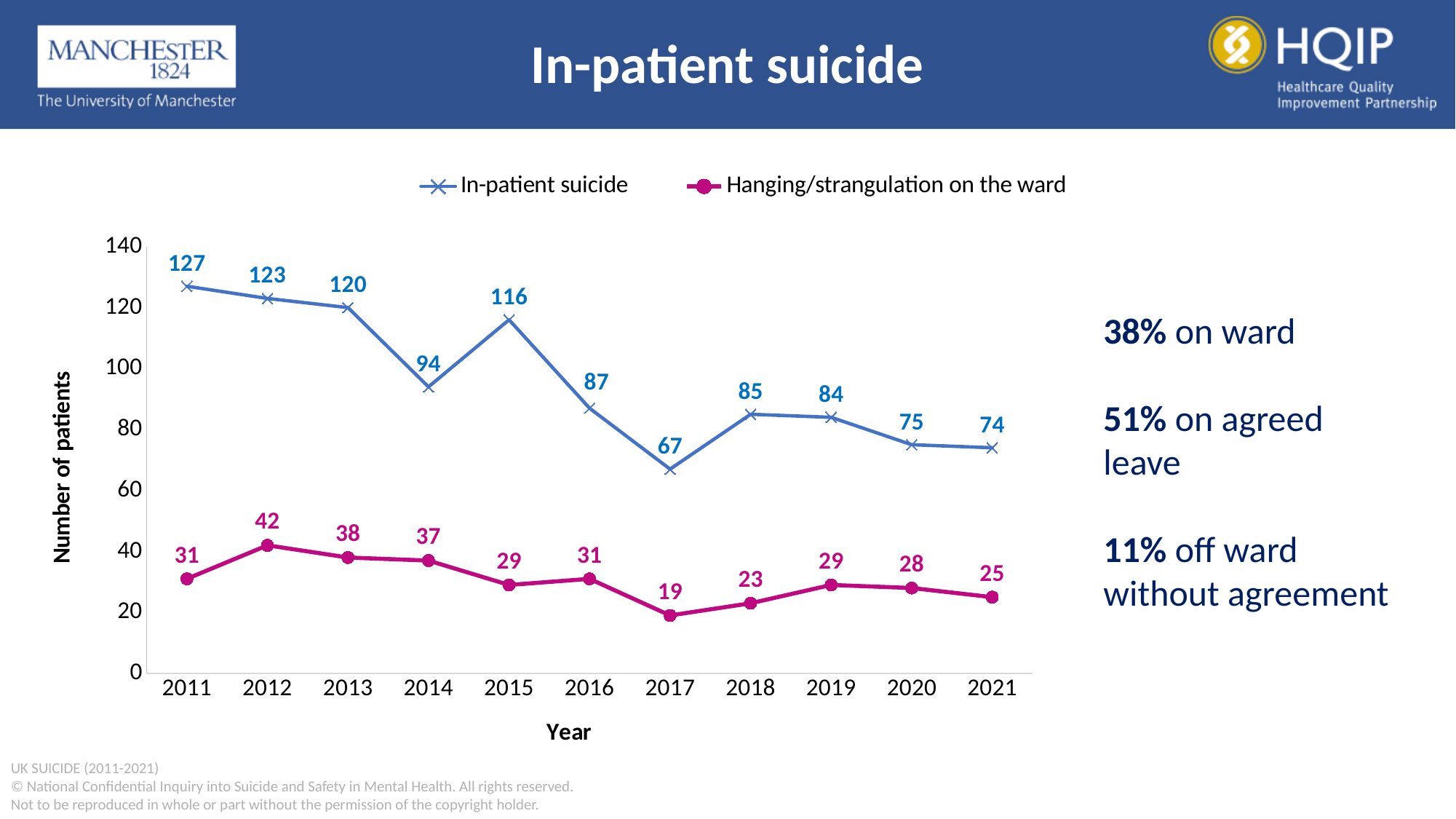
Overall, do in-patient suicides rise or fall from 2011 to 2021? Fall What was the number of hanging/strangulation on the ward cases in 2017? 19 What is the label on the y axis of the chart? Number of patients What is the difference between in-patient suicides in 2011 and 2021? 53 Which was larger, in-patient suicides in 2014 or in 2015? 2015 In which year was the number of in-patient suicides lowest? 2017 What kind of chart is shown on the slide? Line chart In which year was the number of hanging/strangulation on the ward cases highest? 2012 How many series does the legend list? 2 How many years are shown on the x axis? 11 What was the number of in-patient suicides in 2011? 127 What was the number of in-patient suicides in 2021? 74